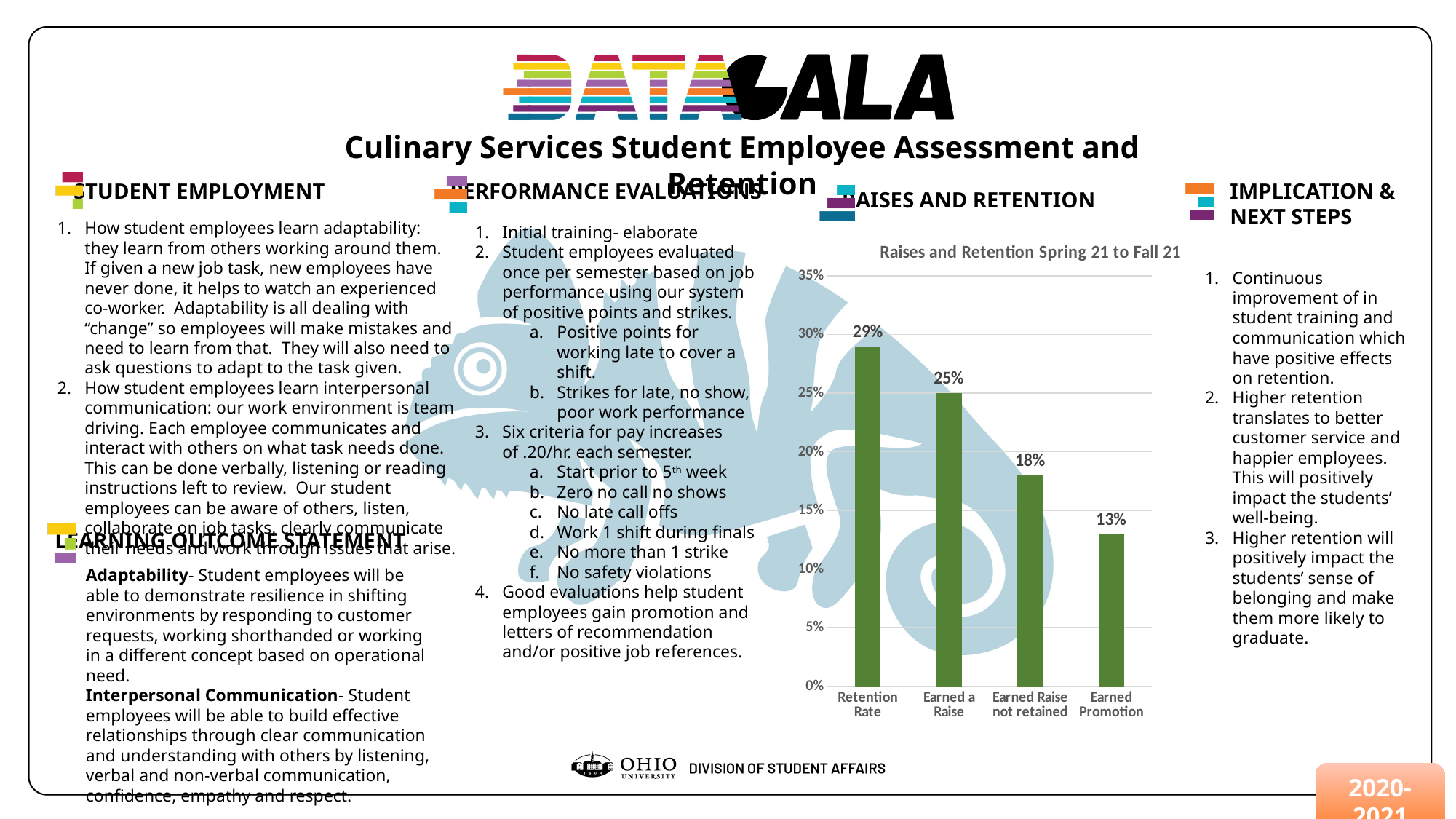
Which is larger, Earned a Raise or Earned Raise not retained? Earned a Raise Is the value for Earned Raise not retained greater or less than 20%? less What is the value for Earned Raise not retained? 18% How many categories are shown in the chart? 4 Which category has the lowest value? Earned Promotion Which category has the highest value? Retention Rate What is the value for Retention Rate? 29% What is the value for Earned a Raise? 25% What is the difference between Retention Rate and Earned Promotion? 16% What is the value for Earned Promotion? 13% What kind of chart is shown? bar chart What is the title of the chart? Raises and Retention Spring 21 to Fall 21